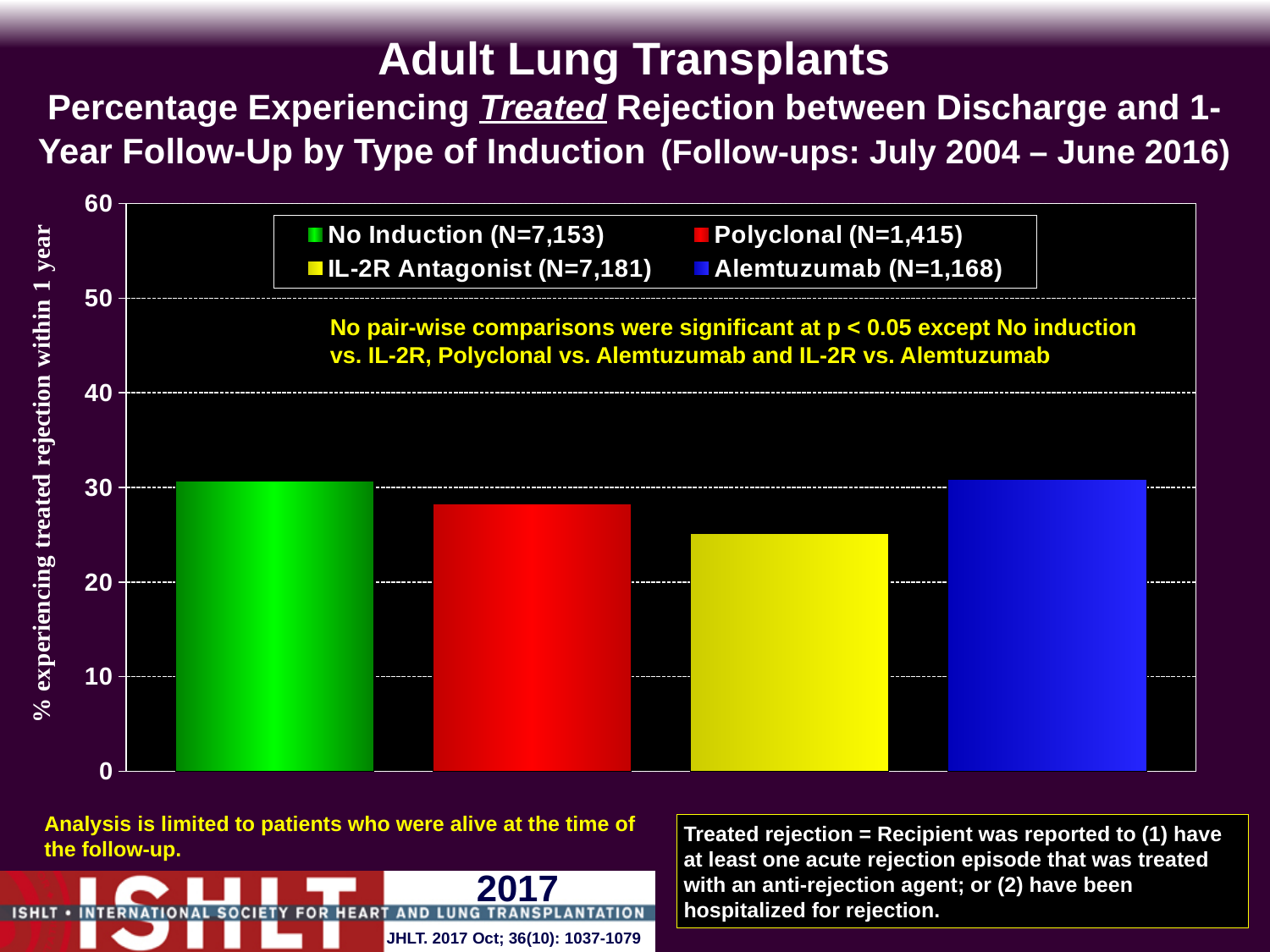
According to the legend, what is the N for the Polyclonal group? 1,415 Which is larger, the value for Polyclonal or the value for IL-2R Antagonist? Polyclonal Is the value for IL-2R Antagonist greater or less than 30? less How many bars are plotted in the chart? 4 Which is larger, the value for No Induction or the value for IL-2R Antagonist? No Induction Which induction type has the lowest percentage experiencing treated rejection within 1 year? IL-2R Antagonist Is the value for IL-2R Antagonist greater or less than 20? greater What kind of chart is shown on the slide? bar chart Is the value for Alemtuzumab greater or less than 20? greater How many series does the legend list? 4